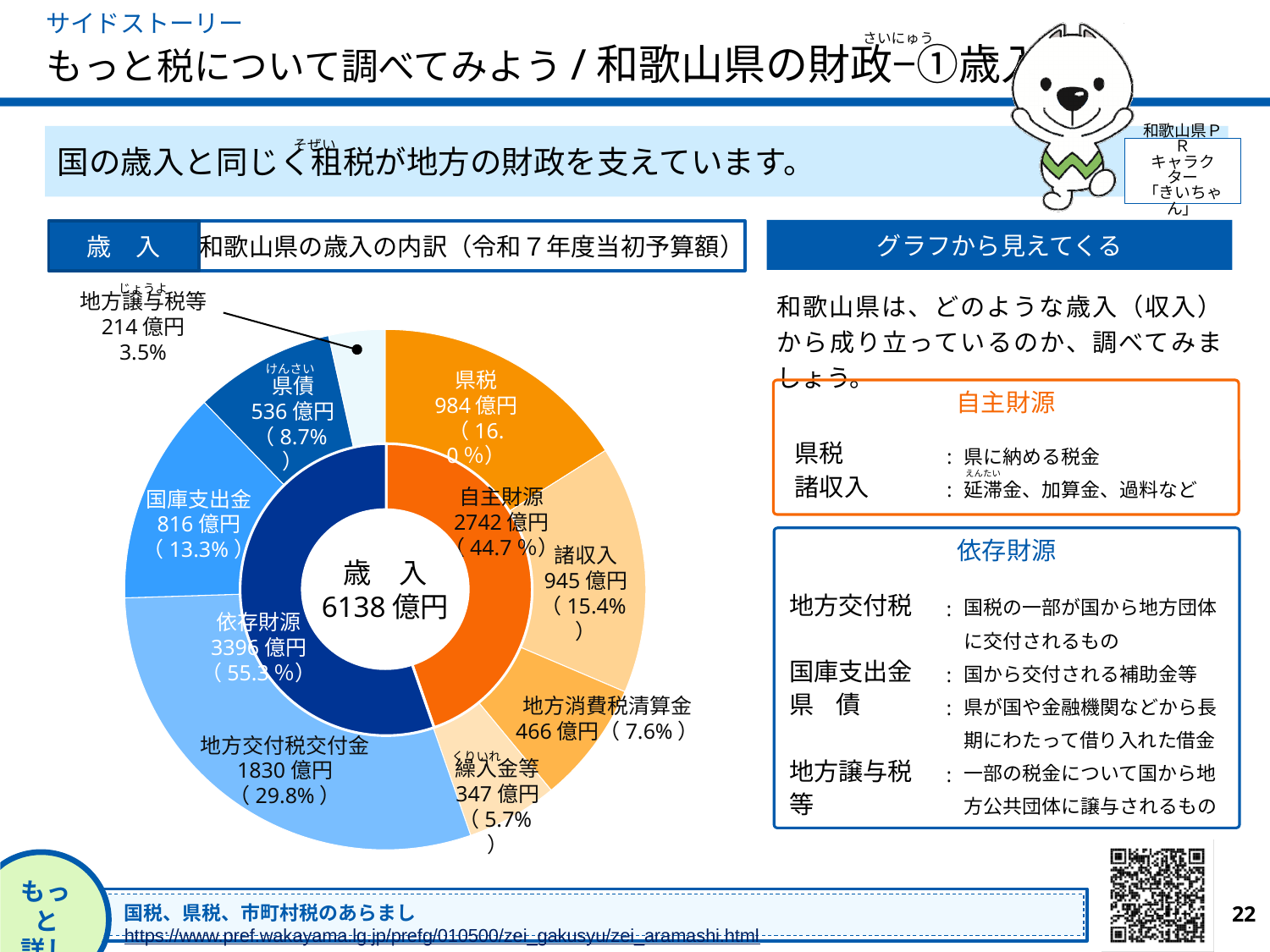
Which category in the outer ring of the revenue chart is the largest? 地方交付税交付金 How many categories are shown in the outer ring of the revenue chart? 8 What percentage share does 地方交付税交付金 have in the revenue chart? 29.8% What is the total revenue (歳入) shown in the centre of the chart? 6138 億円 What is the difference in 億円 between 県税 and 諸収入? 39 億円 What kind of chart is used to show the breakdown of Wakayama Prefecture's revenue (歳入)? Donut (pie) chart Which is larger, 自主財源 or 依存財源? 依存財源 Which category in the outer ring of the revenue chart is the smallest? 地方譲与税等 What is the value for 県債 in the revenue chart? 536 億円 What is the value for 国庫支出金 in the revenue chart? 816 億円 What percentage share does 自主財源 have in the revenue chart? 44.7% What is the value for 県税 in the revenue chart? 984 億円